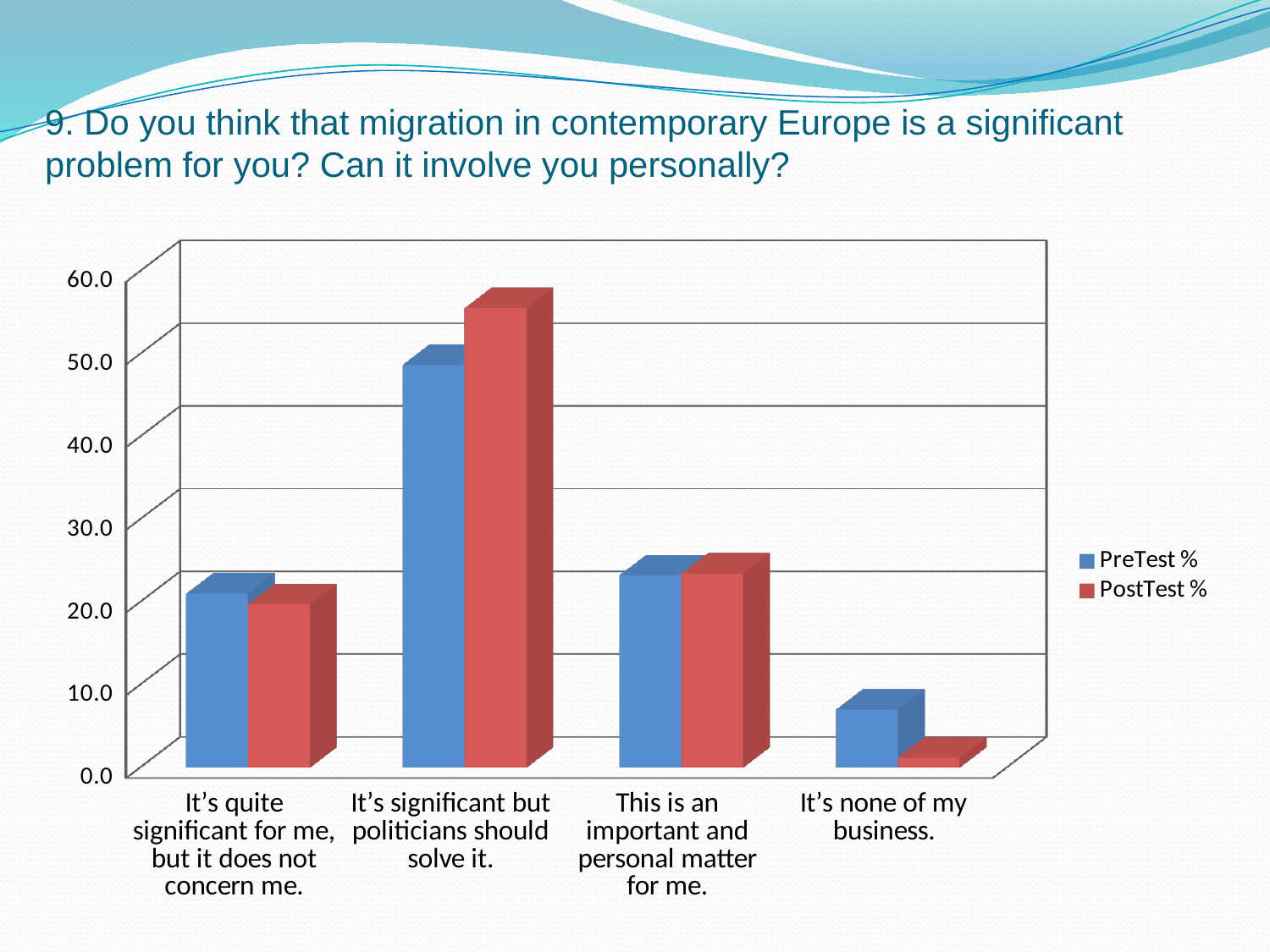
Which category has the lowest PreTest % value? It's none of my business. Is the PostTest % value for 'It's significant but politicians should solve it.' greater or less than 50.0? greater Is the PreTest % value for 'It's none of my business.' greater or less than 10.0? less How many series does the legend list? 2 For 'It's none of my business.', which is larger, PreTest % or PostTest %? PreTest % For 'It's significant but politicians should solve it.', which is larger, PreTest % or PostTest %? PostTest % Which category has the highest PostTest % value? It's significant but politicians should solve it. What kind of chart is shown on the slide? bar chart Is the PreTest % value for 'It's quite significant for me, but it does not concern me.' greater or less than 30.0? less How many answer categories are shown on the x axis? 4 Which category has the lowest PostTest % value? It's none of my business. What are the two legend entries of the chart? PreTest % and PostTest %